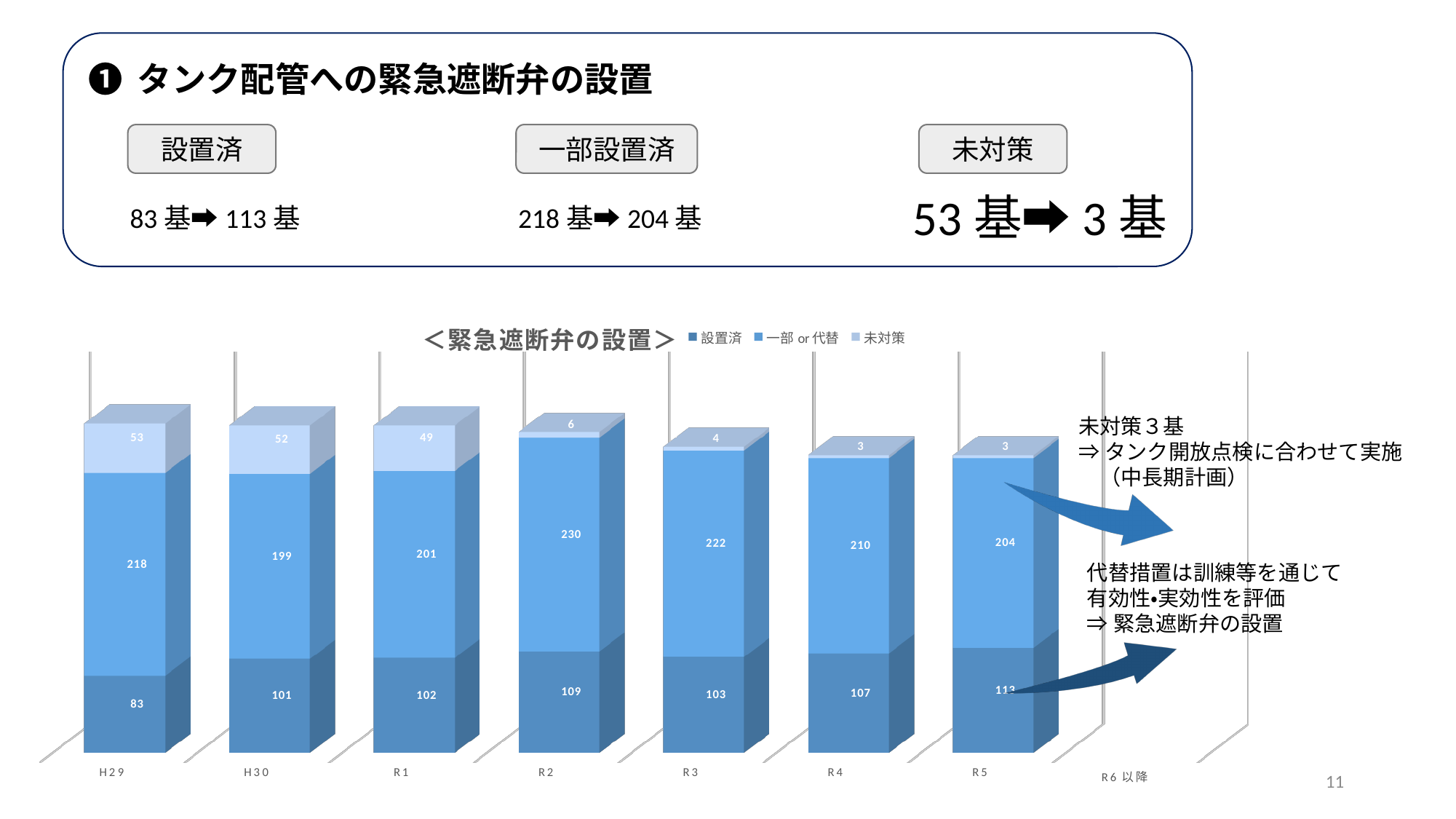
What is the total of the stacked bar for H29? 354 What is the value of 未対策 for R1? 49 Which year has the lowest 設置済 value? H29 Which year has the highest 未対策 value? H29 What is the difference between the 設置済 values for R5 and H29? 30 What is the value of 設置済 for H29? 83 What type of chart is shown on the slide? Stacked bar chart How many stacked bars are plotted in the chart? 7 Which is larger, the 一部 or 代替 value for R3 or for R4? R3 Which year has the highest 設置済 value? R5 What is the value of 一部 or 代替 for R2? 230 How many series does the chart legend list? 3